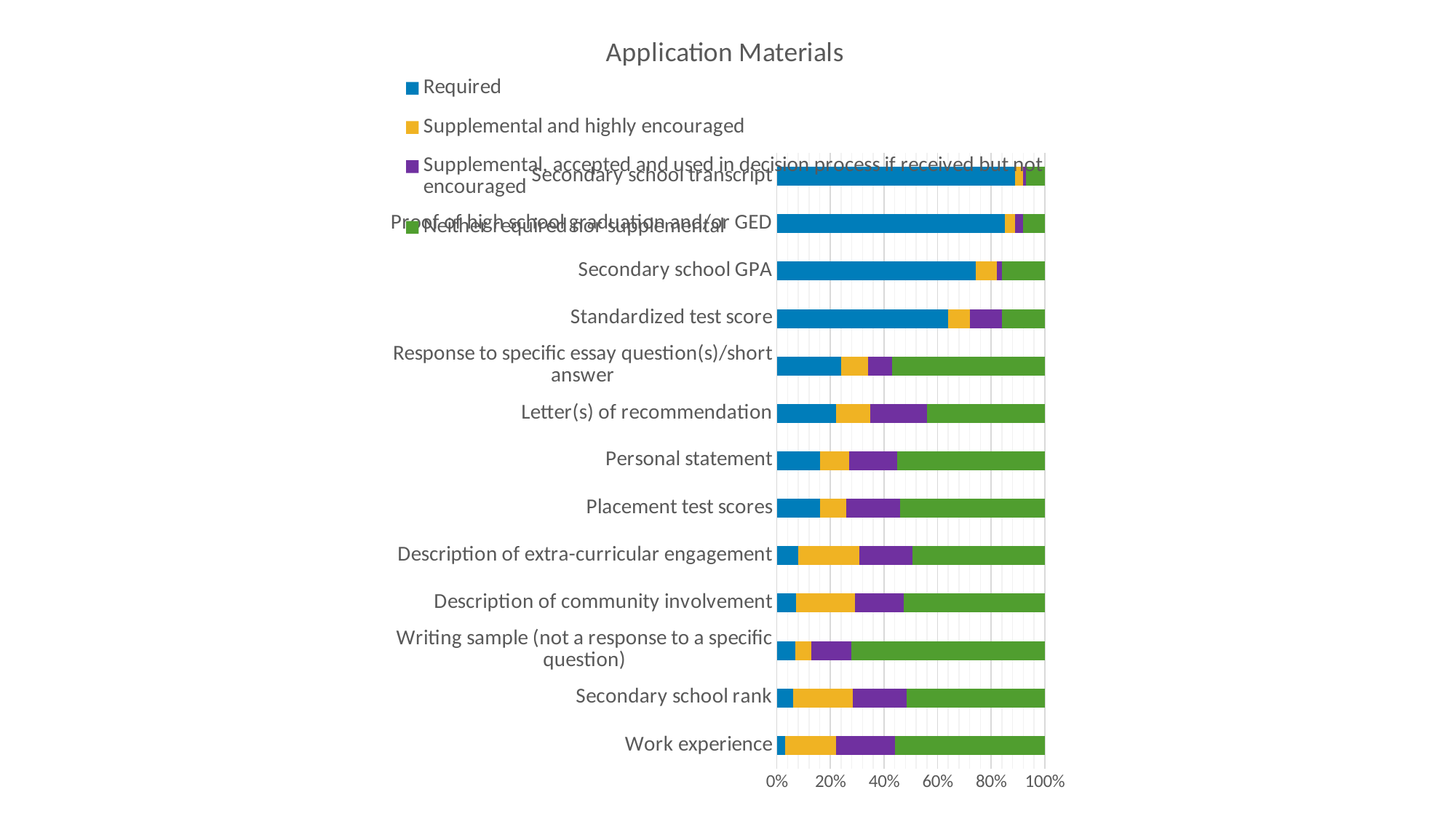
How many series does the legend list? 4 Which has a larger Neither required nor supplemental share: Writing sample (not a response to a specific question) or Secondary school rank? Writing sample (not a response to a specific question) Which has a larger Required share: Secondary school GPA or Standardized test score? Secondary school GPA Which category has the smallest Required share? Work experience Is the Required share for Proof of high school graduation and/or GED greater or less than 80%? greater Is the Neither required nor supplemental share for Writing sample (not a response to a specific question) greater or less than 60%? greater What is the title of the chart? Application Materials Is the Required share for Secondary school GPA greater or less than 60%? greater Which category has the largest Required share? Secondary school transcript What kind of chart is shown on the slide? Stacked bar chart How many application material categories are plotted on the chart? 13